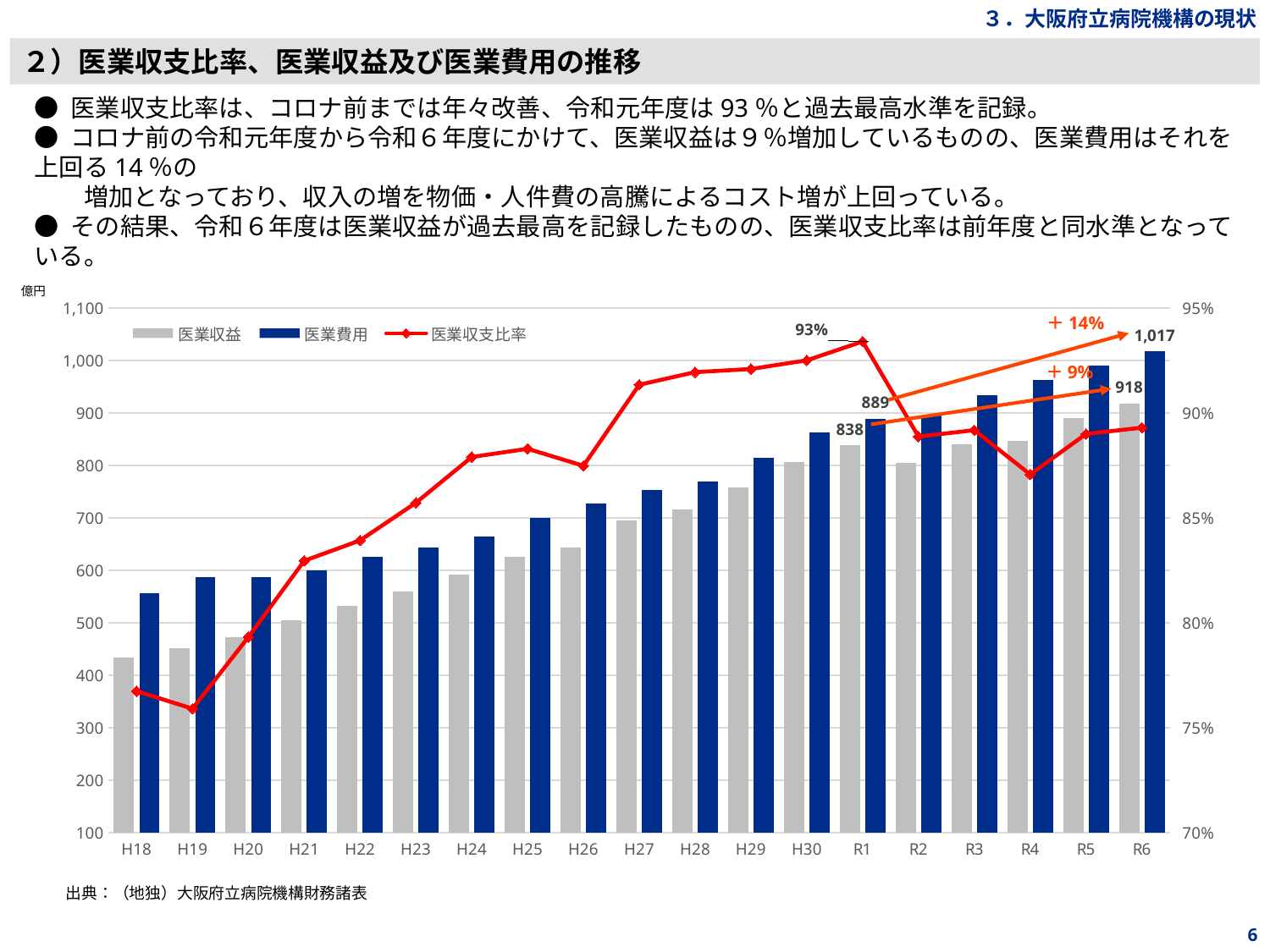
What is the value of 医業費用 for R1? 889 What is the value of 医業収益 for R1? 838 In which year is 医業収支比率 lowest? H19 What is the value of 医業収益 for R6? 918 What is the difference between 医業費用 and 医業収益 for R1? 51 What is the difference between 医業費用 and 医業収益 for R6? 99 What is the 医業収支比率 for R1? 93% What kind of chart is this? Combined bar and line chart How many series does the legend list? 3 Is the value of 医業収益 for H18 greater or less than 500? less How many fiscal years are shown on the x axis? 19 What is the value of 医業費用 for R6? 1,017